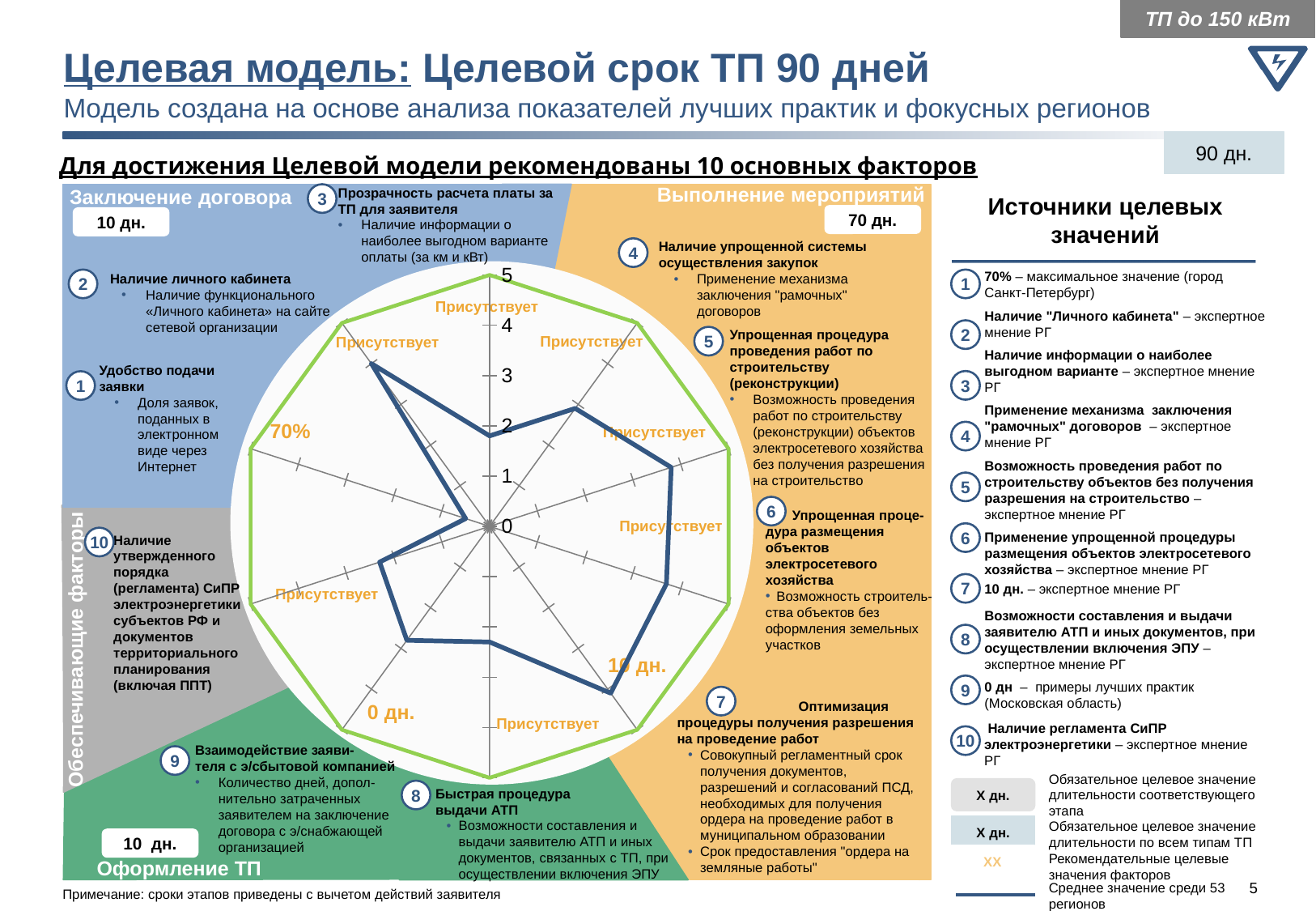
On which tick value does the green outer line lie on every axis of the radar chart? 5 Is the dark blue line's value on the upper-left axis labelled "Присутствует" greater or less than 3? greater What is the highest tick value on the radar chart's scale? 5 According to the legend at the bottom right, what does the dark blue line on the radar chart represent? Среднее значение среди 53 регионов What kind of chart is shown in the centre of the slide? Radar chart Is the dark blue line's value on the lower-right axis labelled "10 дн." greater or less than 3? greater How many axes (factors) does the radar chart have? 10 What is the lowest tick value on the radar chart's scale? 0 How many data lines are plotted on the radar chart? 2 Is the dark blue line's value on the top axis of the radar chart greater or less than 3? less